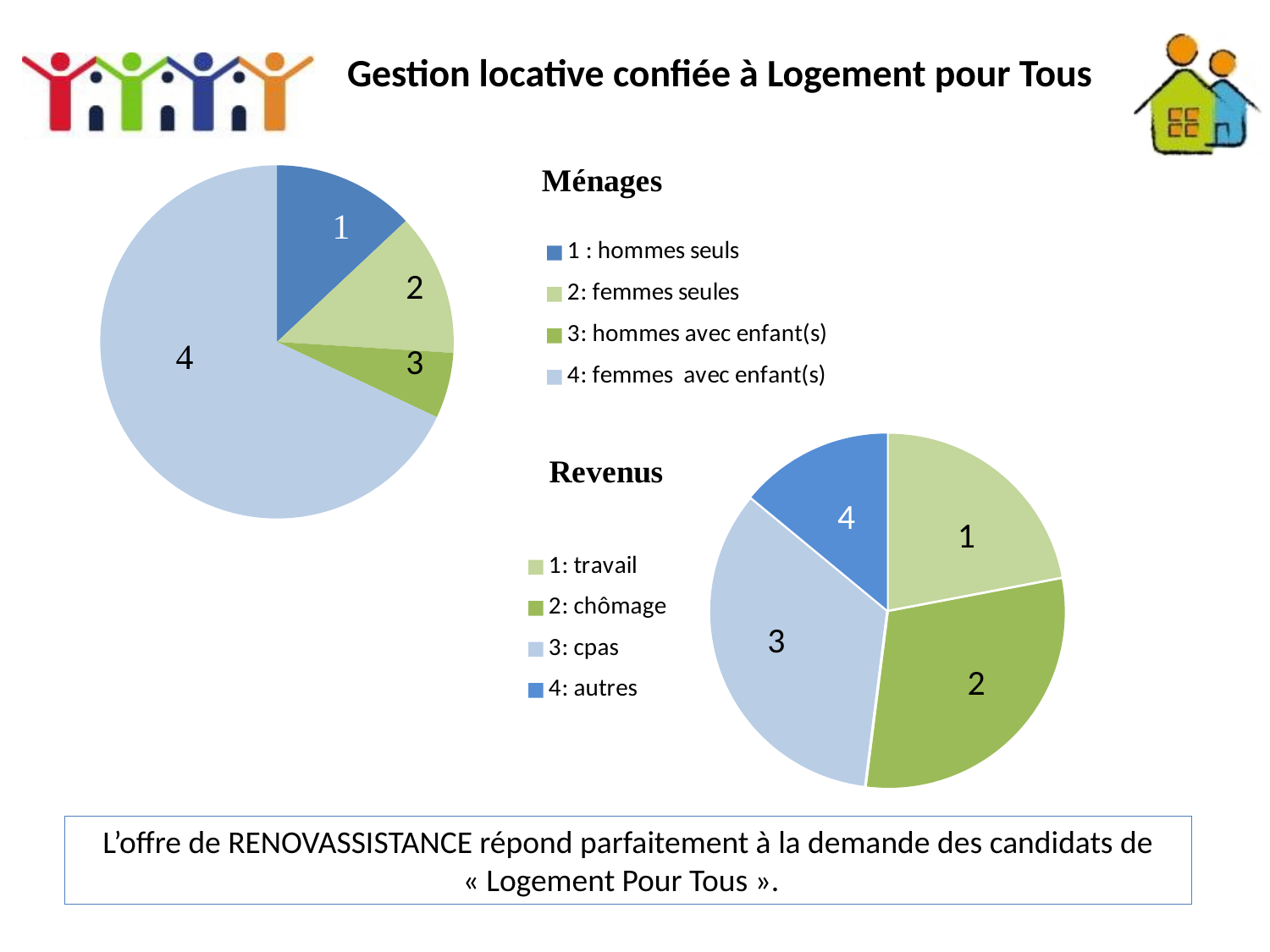
In the Ménages chart, which category has the smallest slice? 3: hommes avec enfant(s) In the Revenus chart, what does legend entry 3 stand for? cpas In the Ménages chart, which category has the largest slice? 4: femmes avec enfant(s) In the Ménages chart, how many entries does the legend list? 4 What kind of chart is the Revenus chart? pie chart What kind of chart is the Ménages chart? pie chart In the Revenus chart, which category has the smallest slice? 4: autres In the Ménages chart, which slice is larger: 1 (hommes seuls) or 3 (hommes avec enfant(s))? 1: hommes seuls In the Revenus chart, which slice is larger: 2 (chômage) or 4 (autres)? 2: chômage In the Ménages chart, how many categories are shown? 4 In the Revenus chart, how many categories are shown? 4 In the Revenus chart, which slice is larger: 1 (travail) or 4 (autres)? 1: travail